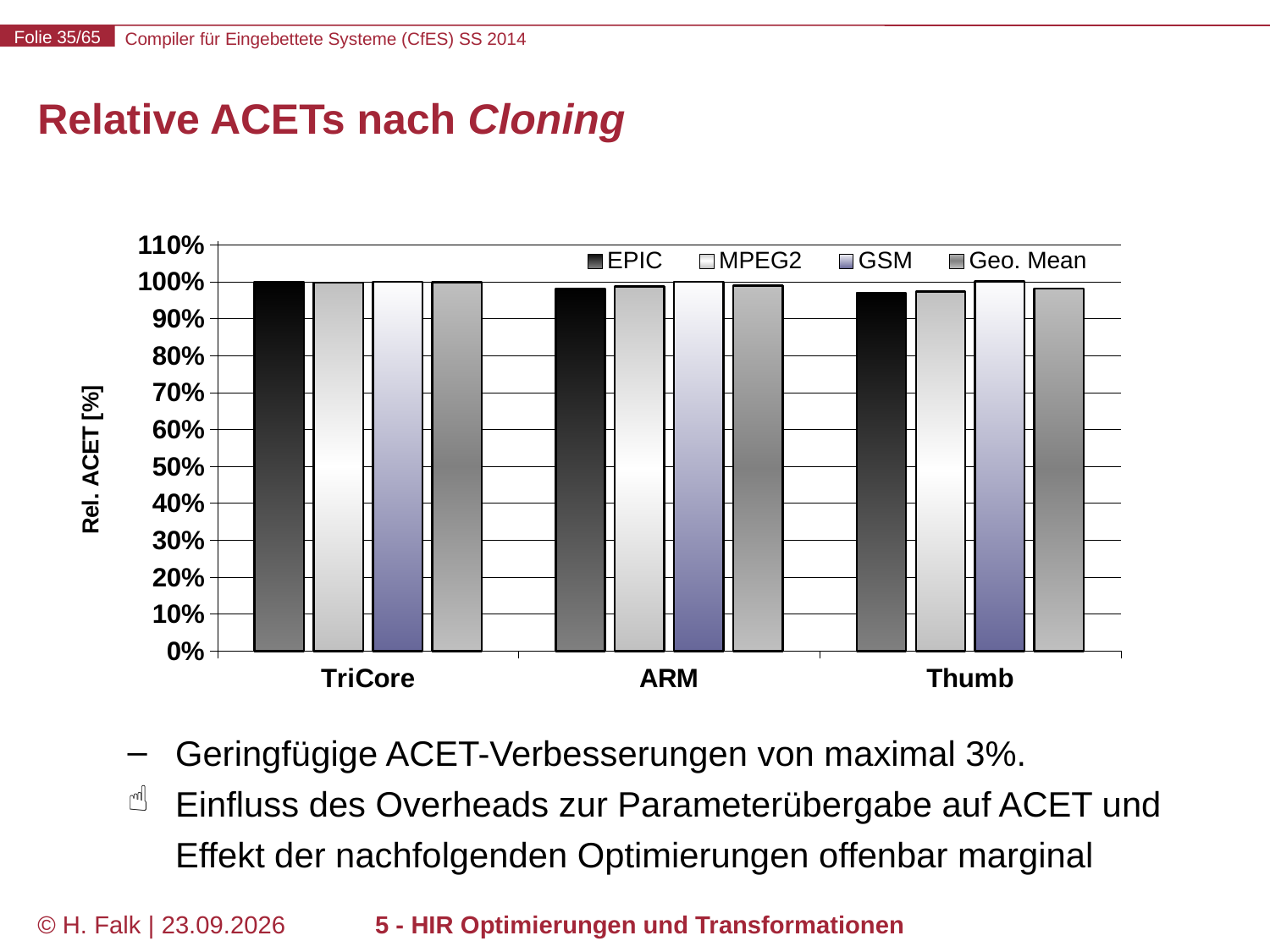
How many categories are shown on the x axis of the chart? 3 Is the value for GSM on Thumb greater or less than 90%? greater Which series are listed in the chart's legend? EPIC, MPEG2, GSM, Geo. Mean What is the label of the y axis of the chart? Rel. ACET [%] Is the value for EPIC on TriCore greater or less than 90%? greater What kind of chart is shown on the slide? bar chart Is the value for EPIC on Thumb greater or less than 80%? greater How many series does the chart's legend list? 4 What are the three categories shown on the x axis of the chart? TriCore, ARM, Thumb